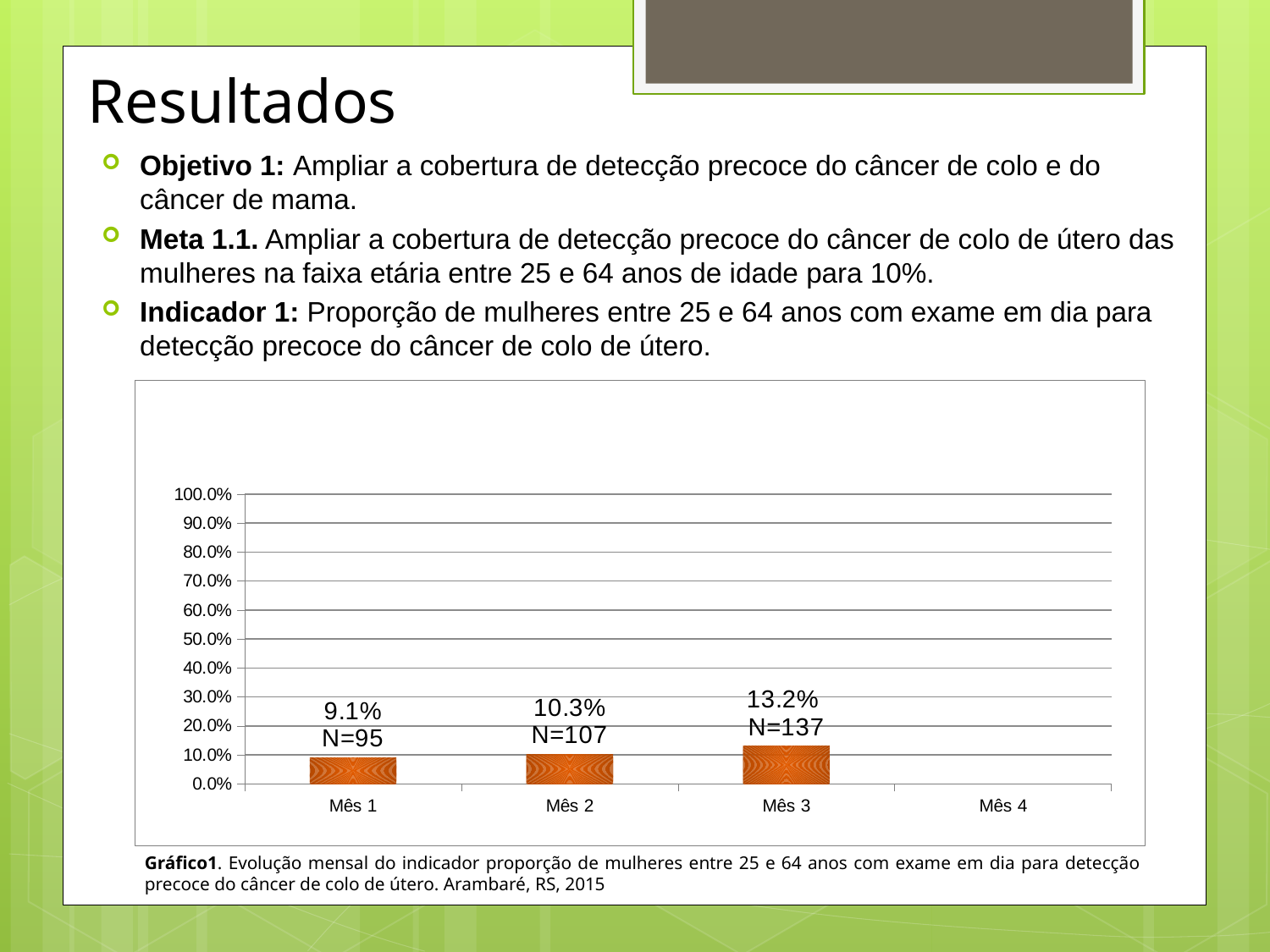
What is the value for Mês 2? 10.3% Which is larger, the value for Mês 2 or Mês 1? Mês 2 Which month with a plotted bar has the lowest value? Mês 1 Is the value for Mês 3 greater or less than 20.0%? less What kind of chart is shown? bar chart Do the values rise or fall from Mês 1 to Mês 3? rise What is the value for Mês 3? 13.2% How many month categories are shown on the x axis? 4 What is the N shown for Mês 3? N=137 Which month has the highest value? Mês 3 What is the value for Mês 1? 9.1% What is the difference between the values for Mês 3 and Mês 1? 4.1%